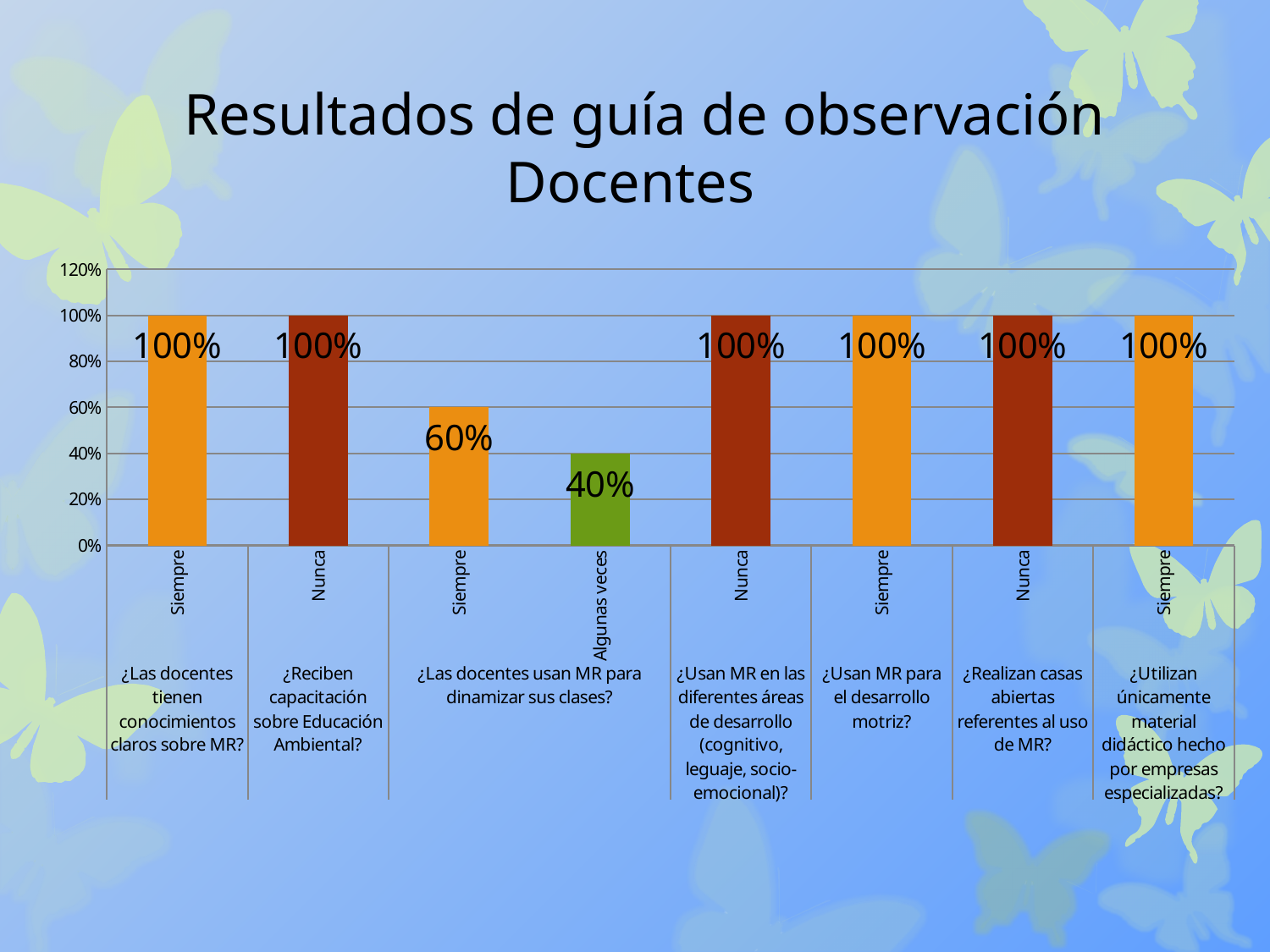
What is the highest value shown on the vertical axis? 120% What is the value of the 'Algunas veces' bar for '¿Las docentes usan MR para dinamizar sus clases?'? 40% Is the value of the 'Algunas veces' bar greater or less than 60%? less How many bars are plotted in the chart? 8 Which bar has the lowest value in the chart? Algunas veces (¿Las docentes usan MR para dinamizar sus clases?) What is the value of the 'Nunca' bar for '¿Reciben capacitación sobre Educación Ambiental?'? 100% What kind of chart is shown on the slide? bar chart What is the value of the 'Siempre' bar for '¿Las docentes usan MR para dinamizar sus clases?'? 60% What is the chart's title? Resultados de guía de observación Docentes What is the value of the 'Siempre' bar for '¿Usan MR para el desarrollo motriz?'? 100% What is the difference between the 'Siempre' and 'Algunas veces' bars for '¿Las docentes usan MR para dinamizar sus clases?'? 20% Which is larger: the 'Siempre' bar for '¿Las docentes usan MR para dinamizar sus clases?' or the 'Algunas veces' bar for the same question? Siempre